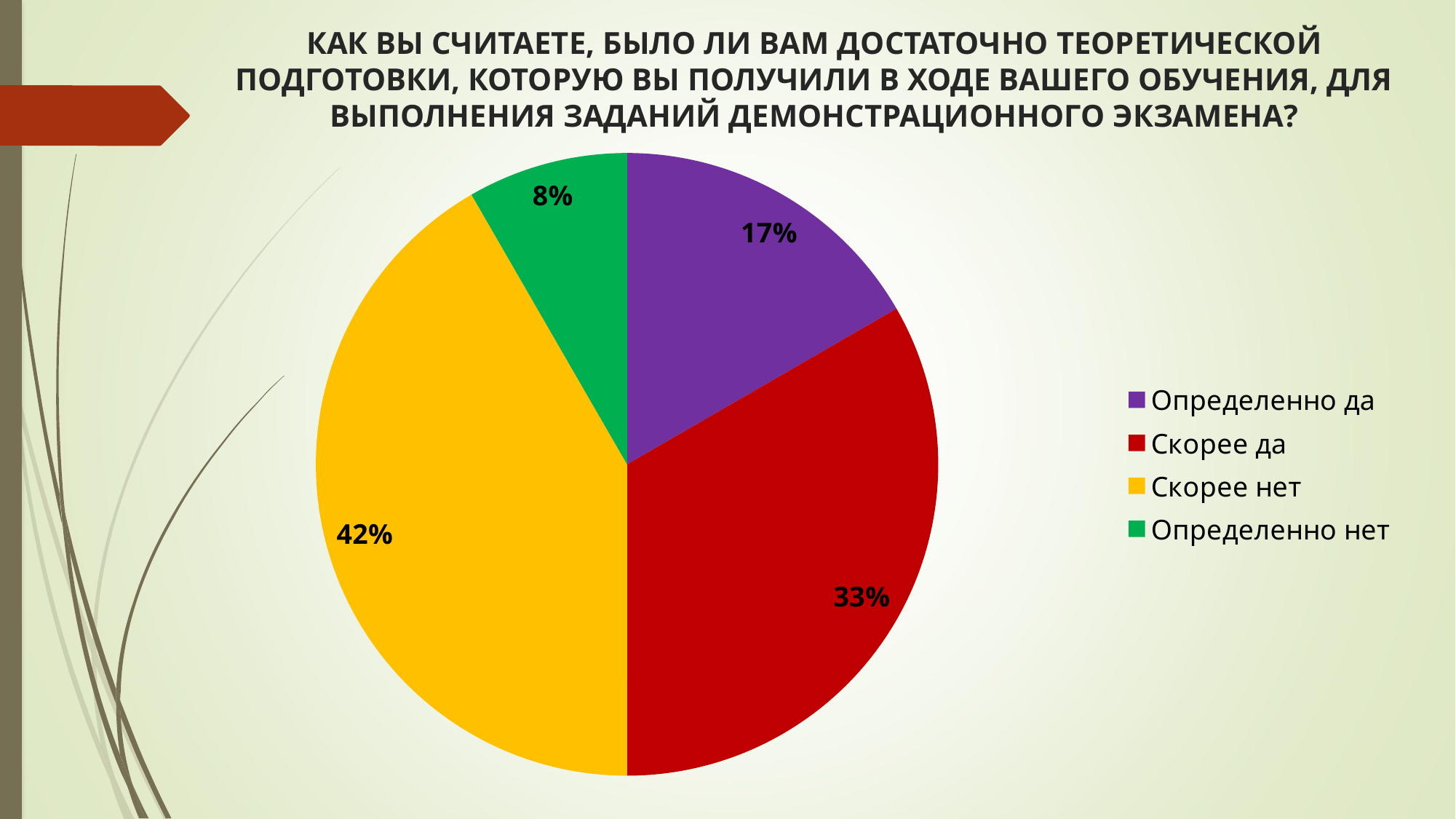
What percentage of respondents answered "Скорее нет"? 42% What is the difference in percentage points between "Скорее нет" and "Скорее да"? 9 Which answer option has the smallest share of the pie? Определенно нет How many categories does the pie chart have? 4 What colour is the slice for "Скорее нет"? yellow What percentage of respondents answered "Скорее да"? 33% What percentage of respondents answered "Определенно нет"? 8% What is the combined share of "Определенно да" and "Скорее да"? 50% Which answer option has the largest share of the pie? Скорее нет What percentage of respondents answered "Определенно да"? 17% What type of chart is shown on the slide? pie chart Which is larger: the share for "Определенно да" or the share for "Скорее да"? Скорее да